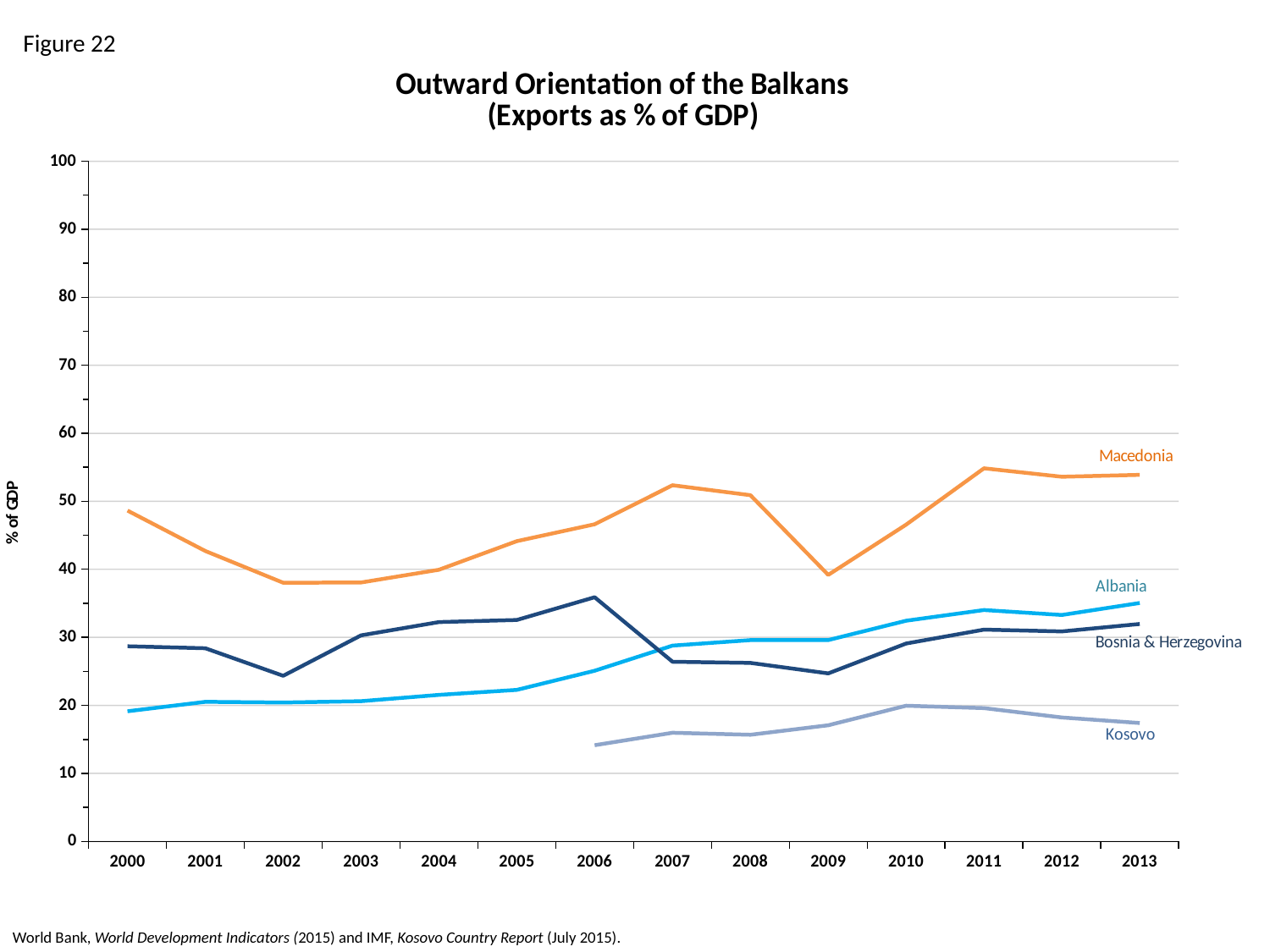
Does the Albania line generally rise or fall from 2000 to 2013? rise What kind of chart is shown on the slide? line chart How many countries are plotted as lines in the chart? 4 Is the value for Albania in 2013 greater or less than 30? greater Which country has the highest exports as % of GDP in 2013? Macedonia In 2006, which is larger: the value for Bosnia & Herzegovina or the value for Albania? Bosnia & Herzegovina Is the value for Macedonia in 2011 greater or less than 50? greater Which country has the lowest exports as % of GDP in 2013? Kosovo Is the value for Kosovo in 2010 greater or less than 30? less In which year does the Bosnia & Herzegovina line reach its highest value? 2006 How many years are shown on the x axis of the chart? 14 Which country's line starts only in 2006 rather than 2000? Kosovo